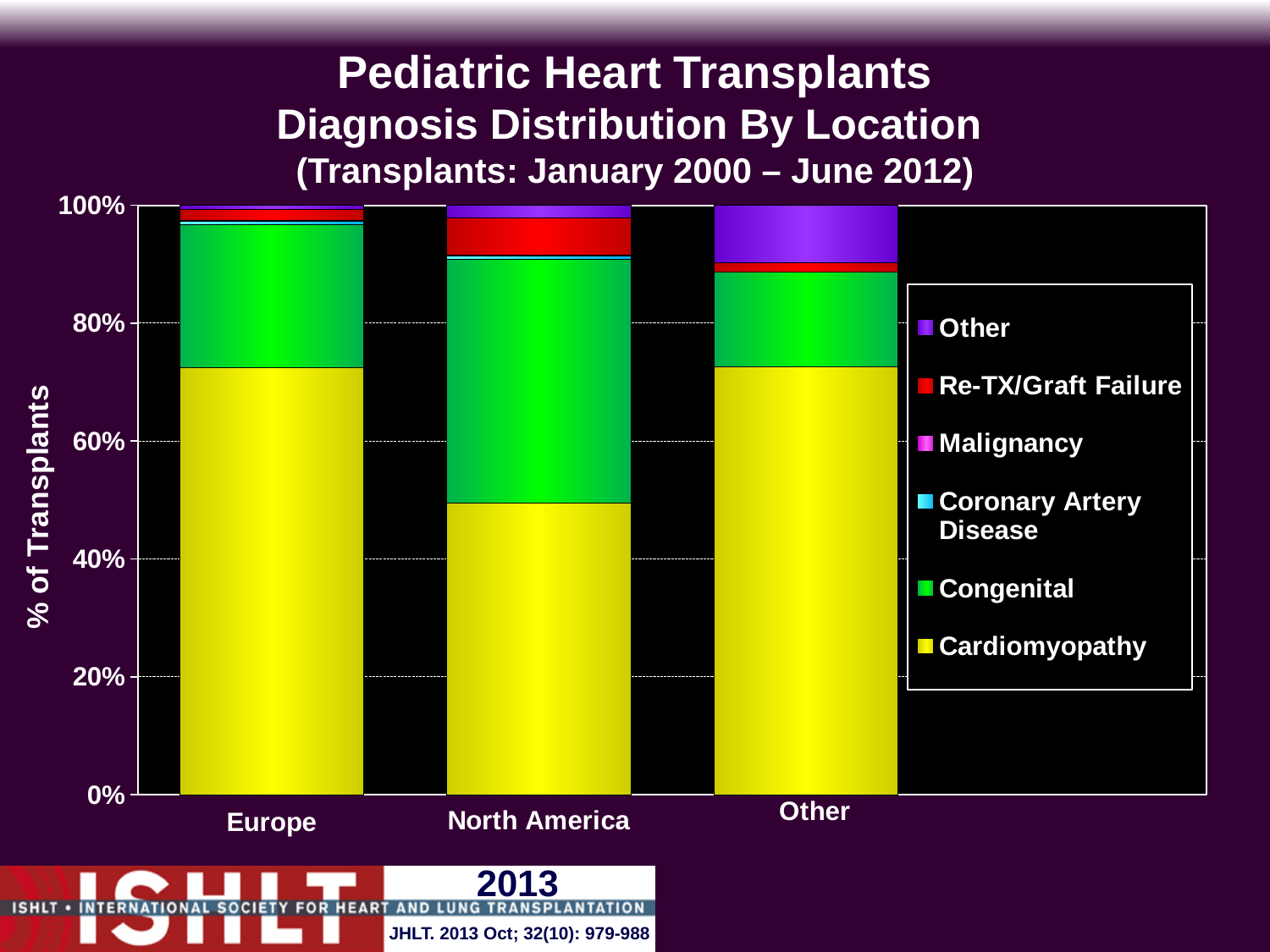
How many locations (categories) are shown on the x axis? 3 Is the Cardiomyopathy share for North America greater or less than 40%? greater Is the Cardiomyopathy share for Other greater or less than 60%? greater What is the time period of transplants covered by the chart, as stated in the title? January 2000 – June 2012 What kind of chart is shown on the slide? stacked bar chart Which location has the lowest Cardiomyopathy share? North America Is the Re-TX/Graft Failure share larger in North America or in Europe? North America Is the Cardiomyopathy share for Europe greater or less than 60%? greater Which location has the largest Other (diagnosis) share? Other How many diagnosis series does the legend list? 6 Which location has the largest Congenital share? North America